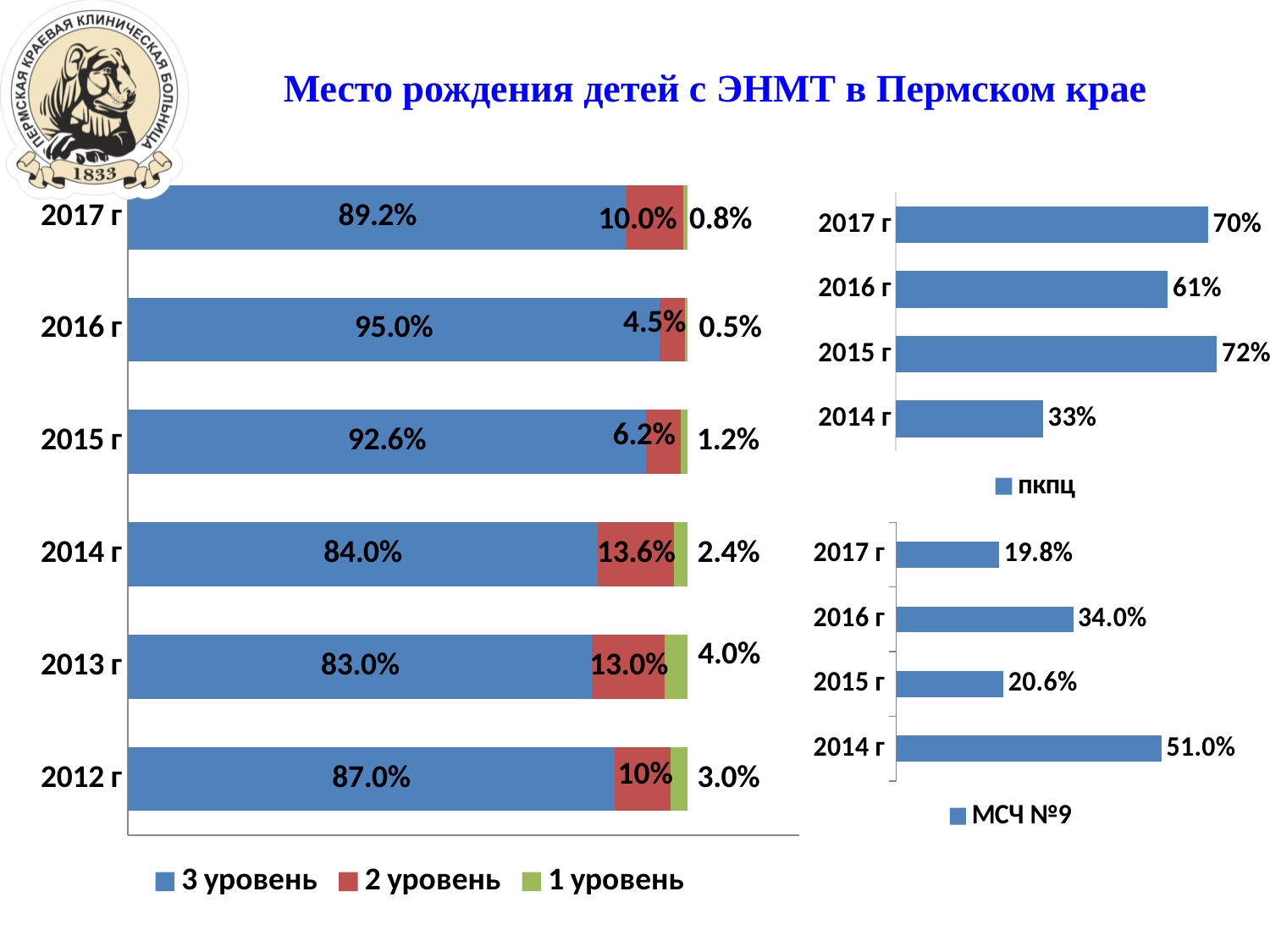
In the large stacked bar chart on the left, what is the value of the 2 уровень series for 2014 г? 13.6% In the ПКПЦ chart at the top right, which year has the highest value? 2015 г In the МСЧ №9 chart at the bottom right, which year has the lowest value? 2017 г In the ПКПЦ chart at the top right, what is the value for 2014 г? 33% In the large stacked bar chart on the left, which year has the highest value for the 3 уровень series? 2016 г In the МСЧ №9 chart at the bottom right, which is larger, the value for 2016 г or the value for 2015 г? 2016 г In the large stacked bar chart on the left, how many series does the legend list? 3 In the large stacked bar chart on the left, what is the value of the 3 уровень series for 2016 г? 95.0% In the ПКПЦ chart at the top right, what is the difference between the values for 2017 г and 2016 г? 9% In the large stacked bar chart on the left, what is the value of the 1 уровень series for 2013 г? 4.0% In the large stacked bar chart on the left, how many years are shown? 6 In the large stacked bar chart on the left, which year has the lowest value for the 1 уровень series? 2016 г